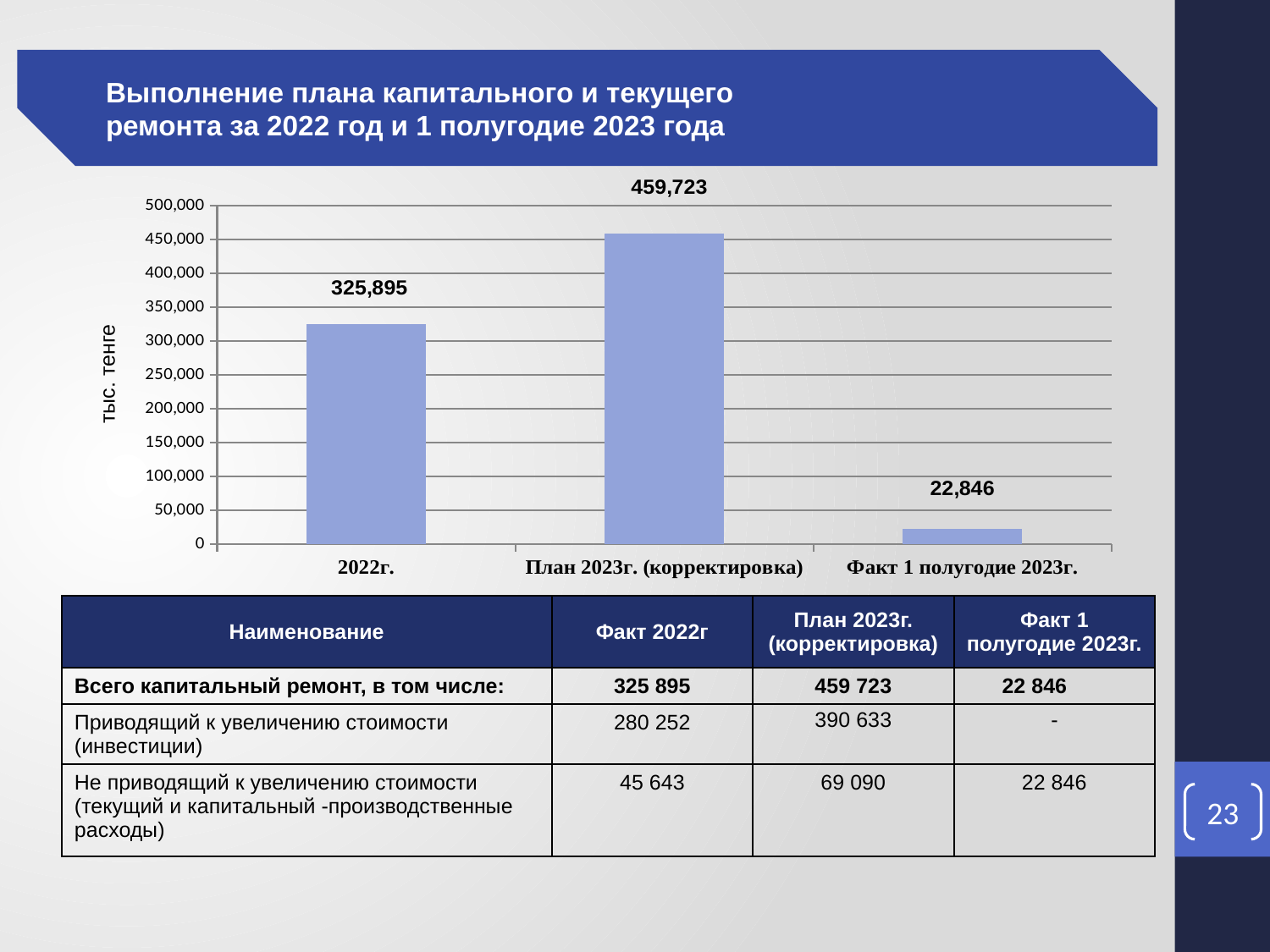
What is the value for Факт 1 полугодие 2023г. in the chart? 22,846 What is the difference between the values for 2022г. and Факт 1 полугодие 2023г.? 303,049 What type of chart is shown on the slide? bar chart What is the difference between the values for План 2023г. (корректировка) and 2022г.? 133,828 How many bars are shown in the chart? 3 What is the value for План 2023г. (корректировка) in the chart? 459,723 What is the label of the vertical axis of the chart? тыс. тенге Is the value for Факт 1 полугодие 2023г. greater or less than 50,000? less Which category has the lowest value in the chart? Факт 1 полугодие 2023г. Which is larger, the value for 2022г. or the value for План 2023г. (корректировка)? План 2023г. (корректировка) Which category has the highest value in the chart? План 2023г. (корректировка) What is the value for 2022г. in the chart? 325,895